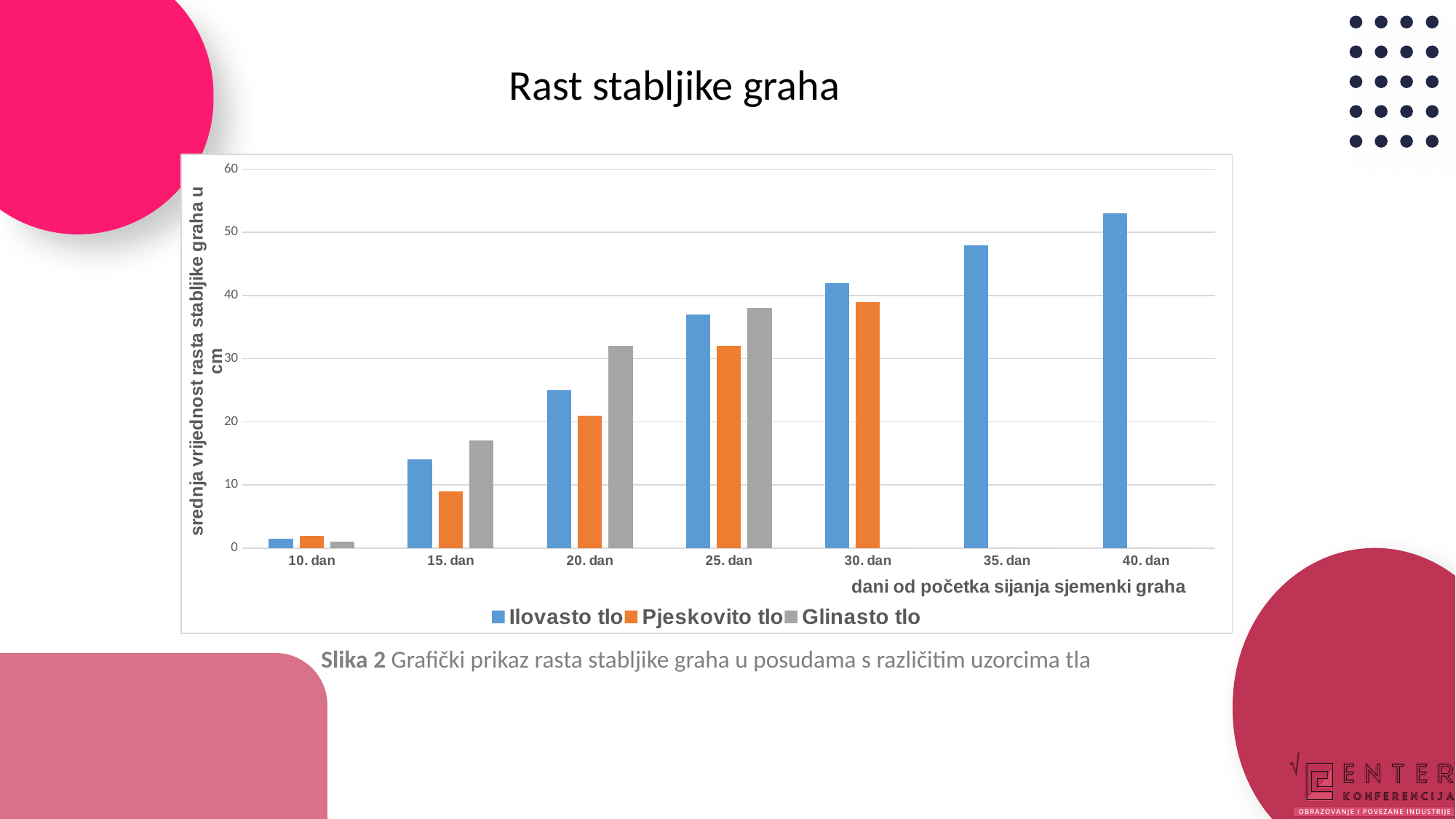
Is the value for Ilovasto tlo at 40. dan greater or less than 50? greater Is the value for Ilovasto tlo at 35. dan greater or less than 50? less Is the value for Glinasto tlo at 20. dan greater or less than 30? greater What is the title of the chart? Rast stabljike graha How many day categories are shown on the x axis? 7 What kind of chart is shown on the slide? bar chart How many series does the legend list? 3 Do the values for Ilovasto tlo rise or fall from 10. dan to 40. dan? rise At 15. dan, which is larger: Ilovasto tlo or Glinasto tlo? Glinasto tlo At 20. dan, which is larger: Ilovasto tlo or Pjeskovito tlo? Ilovasto tlo